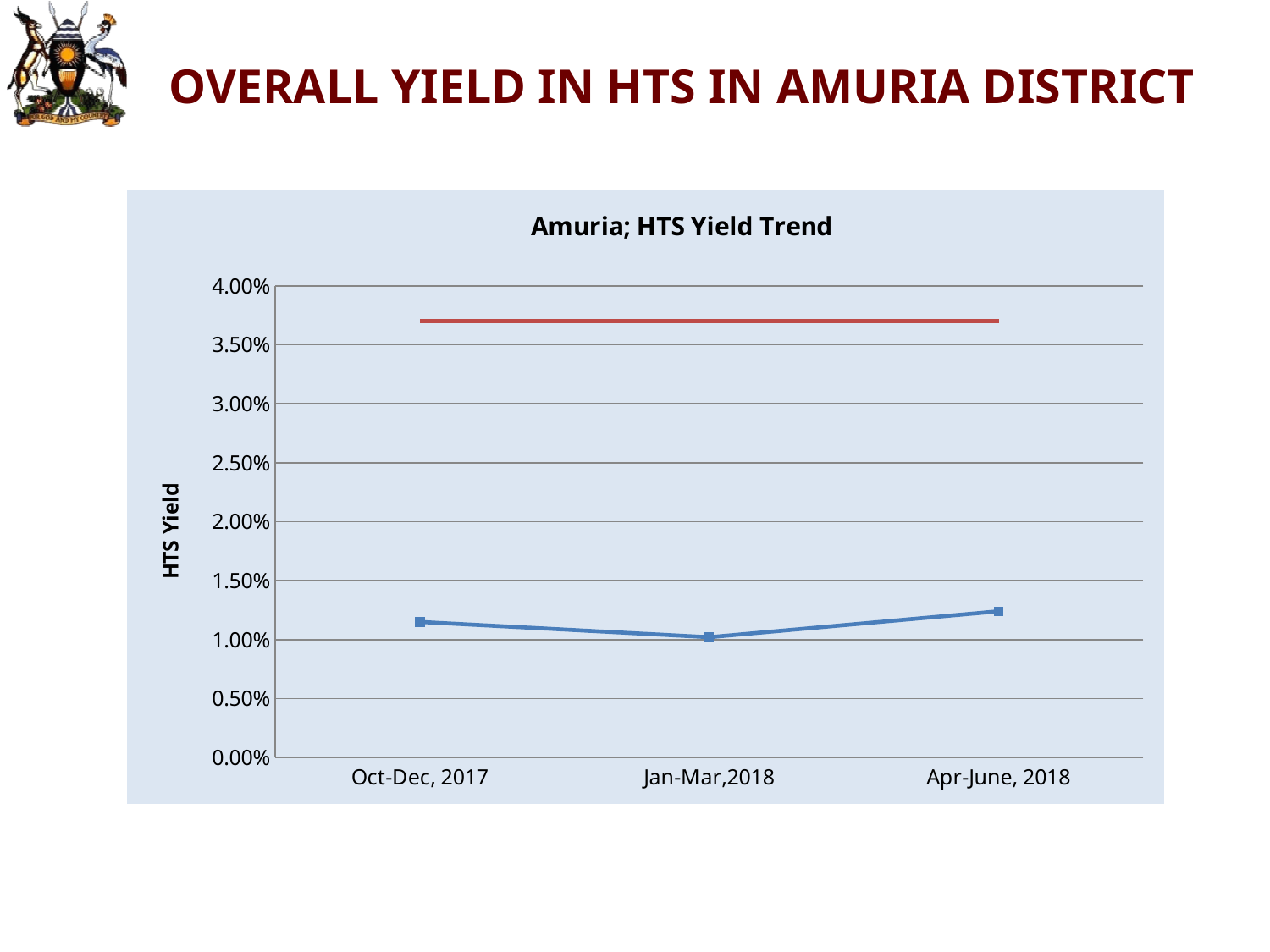
What is the title of the chart? Amuria; HTS Yield Trend Is the HTS yield for Oct-Dec, 2017 greater or less than 1.50%? less Is the flat red line on the chart greater or less than 3.50%? greater Is the HTS yield for Jan-Mar,2018 greater or less than 1.50%? less What kind of chart is shown on the slide? line chart What is the label on the vertical axis of the chart? HTS Yield How many time periods are shown on the x axis of the chart? 3 Which period has the highest HTS yield on the blue line? Apr-June, 2018 How does the HTS yield change from Oct-Dec, 2017 to Jan-Mar,2018? It falls Which has a higher HTS yield, Jan-Mar,2018 or Apr-June, 2018? Apr-June, 2018 Which period has the lowest HTS yield on the blue line? Jan-Mar,2018